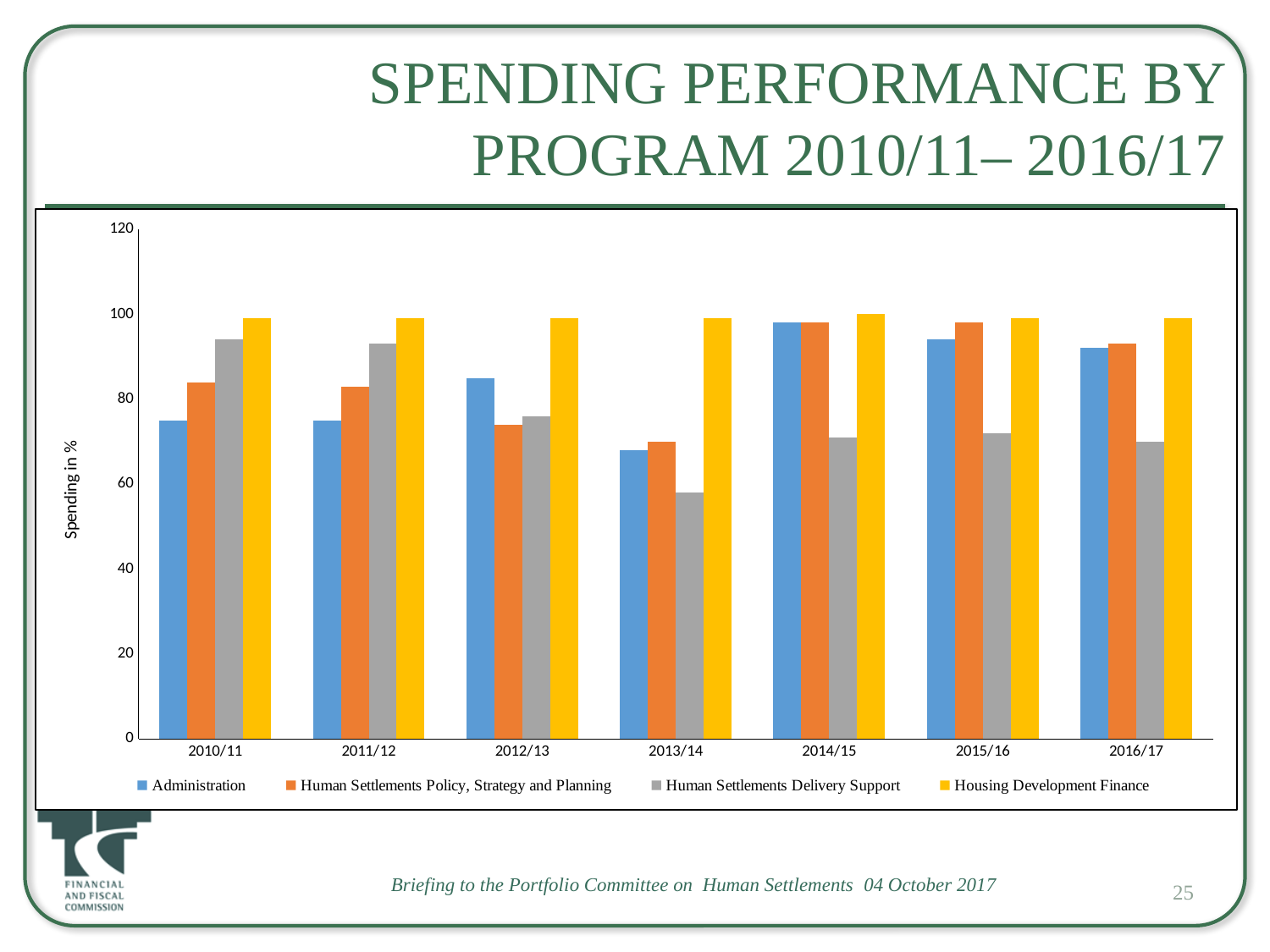
How many financial years are shown on the x axis of the chart? 7 Which program has the lowest spending in 2013/14? Human Settlements Delivery Support Is the value for Administration in 2013/14 greater or less than 80? less Is the value for Human Settlements Delivery Support in 2010/11 greater or less than 80? greater What kind of chart is shown on the slide? Bar chart What is the label on the chart's y axis? Spending in % In which year is the Administration value lowest? 2013/14 How many series does the chart's legend list? 4 In which year is the Human Settlements Delivery Support value lowest? 2013/14 Is the value for Human Settlements Delivery Support in 2014/15 greater or less than 80? less In 2012/13, which is larger: Administration or Human Settlements Policy, Strategy and Planning? Administration